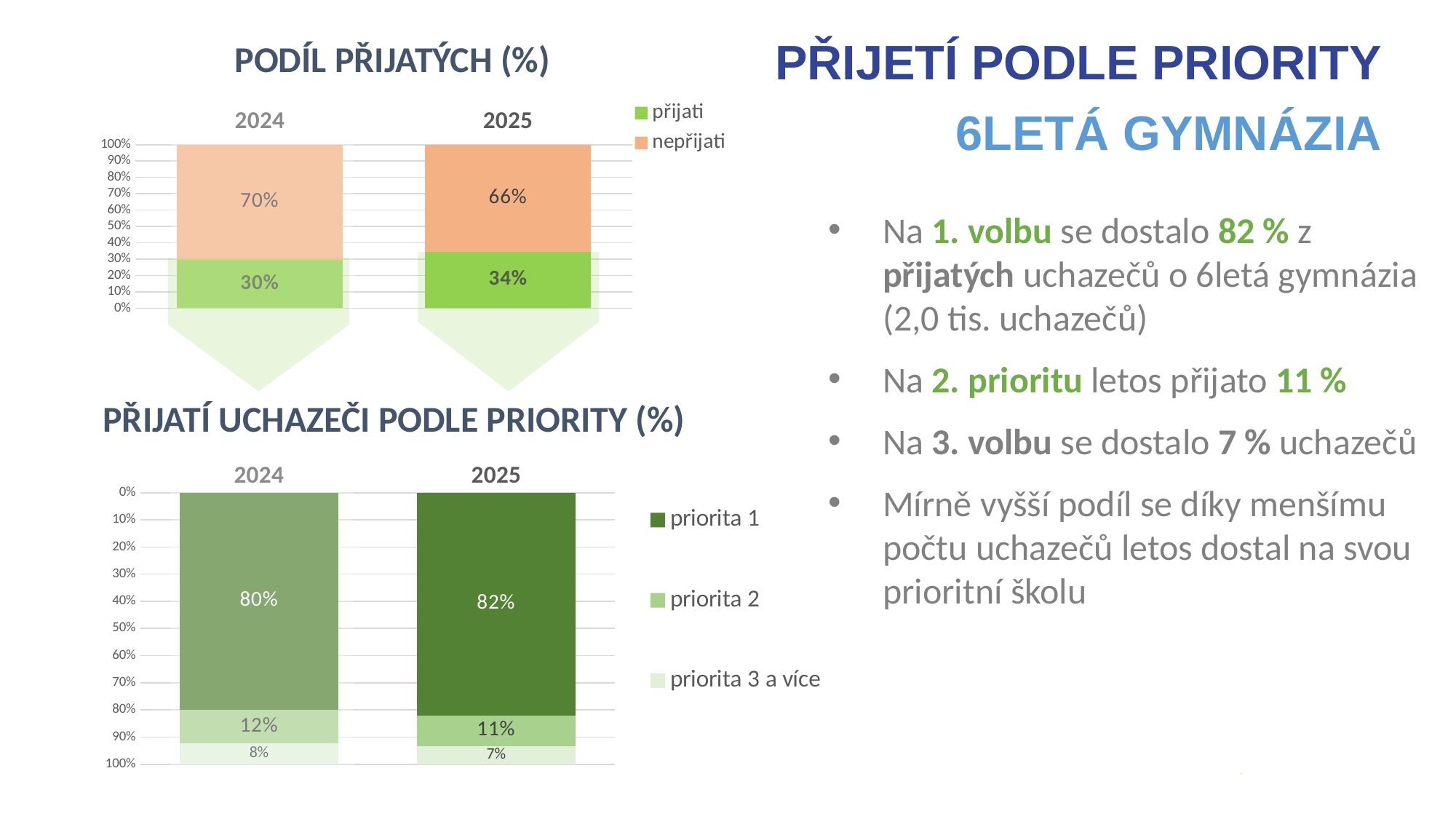
In the chart titled 'PODÍL PŘIJATÝCH (%)', by how many percentage points did the 'přijati' share change from 2024 to 2025? 4 percentage points In the chart titled 'PŘIJATÍ UCHAZEČI PODLE PRIORITY (%)', what is the value for 'priorita 3 a více' in 2024? 8% In the chart titled 'PODÍL PŘIJATÝCH (%)', how many series does the legend list? 2 In the chart titled 'PŘIJATÍ UCHAZEČI PODLE PRIORITY (%)', which series has the lowest value in 2025? priorita 3 a více In the chart titled 'PŘIJATÍ UCHAZEČI PODLE PRIORITY (%)', how many years (categories) are shown on the x axis? 2 In the chart titled 'PŘIJATÍ UCHAZEČI PODLE PRIORITY (%)', what is the value for 'priorita 1' in 2025? 82% In the chart titled 'PODÍL PŘIJATÝCH (%)', what is the value for 'nepřijati' in 2024? 70% In the chart titled 'PODÍL PŘIJATÝCH (%)', what is the value for 'přijati' in 2025? 34% In the chart titled 'PŘIJATÍ UCHAZEČI PODLE PRIORITY (%)', how many series does the legend list? 3 What kind of chart is the chart titled 'PŘIJATÍ UCHAZEČI PODLE PRIORITY (%)'? Stacked bar chart In the chart titled 'PODÍL PŘIJATÝCH (%)', which year has the larger 'nepřijati' share, 2024 or 2025? 2024 In the chart titled 'PŘIJATÍ UCHAZEČI PODLE PRIORITY (%)', what is the total of the 2024 stacked bar? 100%